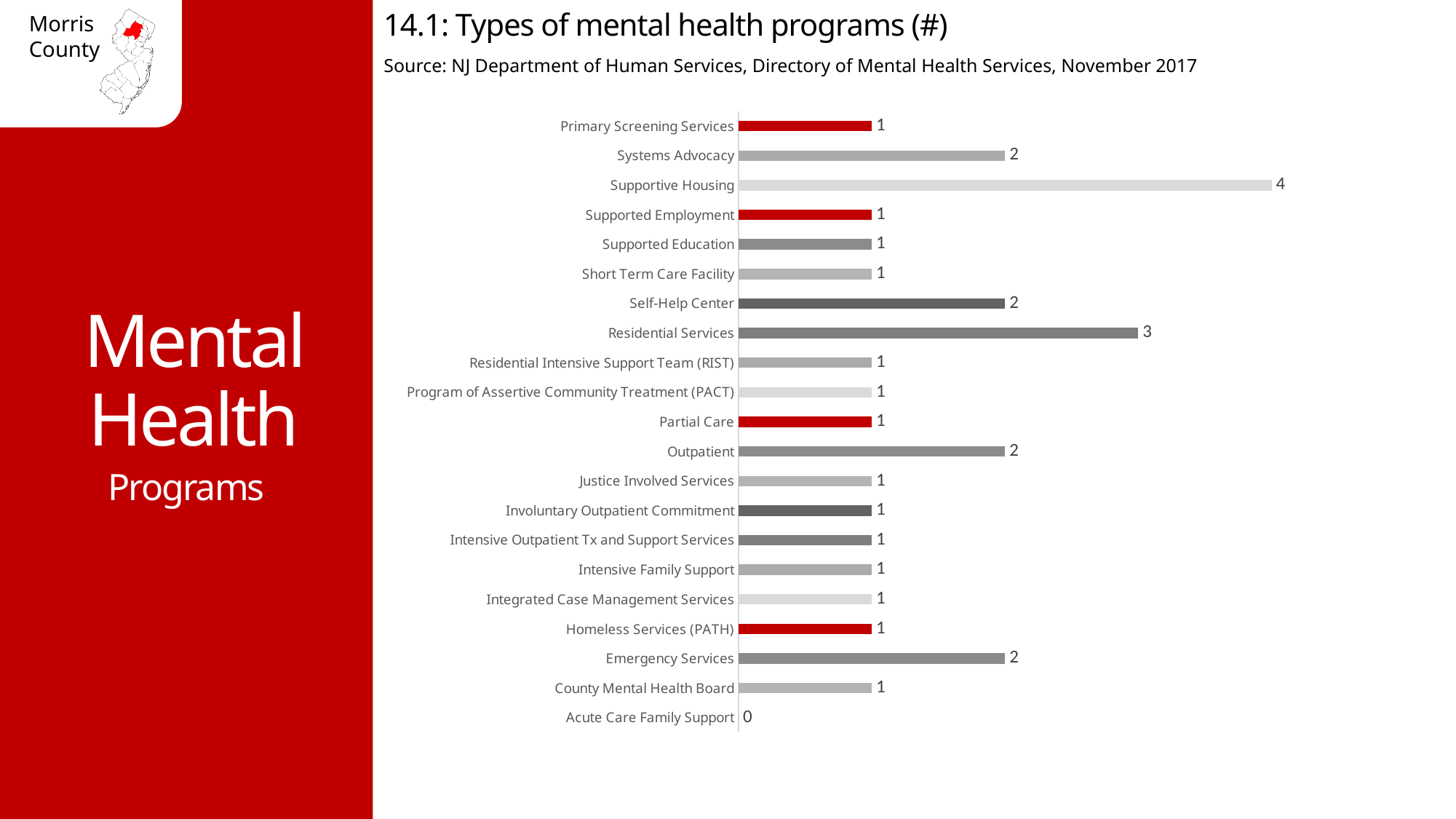
What is the value for Acute Care Family Support? 0 What kind of chart is shown on the slide? Bar chart Which category has the highest value? Supportive Housing Which is larger, the value for Outpatient or the value for Partial Care? Outpatient What is the value for Supportive Housing? 4 How many categories are shown in the chart? 21 What is the difference between the values for Self-Help Center and Supported Education? 1 What is the difference between the values for Supportive Housing and Residential Services? 1 What is the value for Emergency Services? 2 What is the title of the chart? 14.1: Types of mental health programs (#) What is the value for Residential Services? 3 Which category has the lowest value? Acute Care Family Support